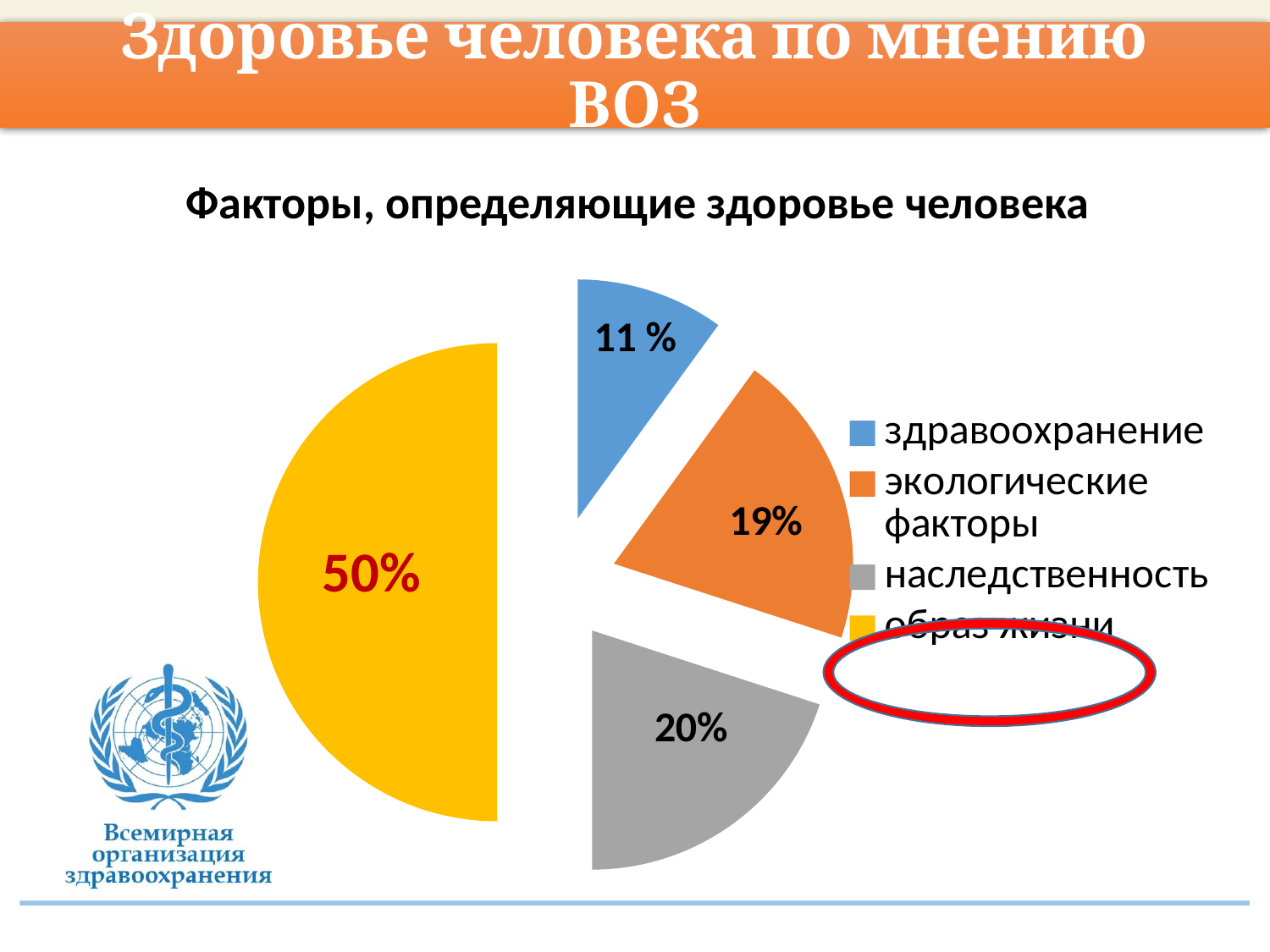
What share of the pie is labelled for образ жизни? 50% How many slices does the pie chart have? 4 Which factor has the largest slice of the pie? образ жизни How many entries does the legend list? 4 What value is shown for экологические факторы? 19% What is the title of the chart? Факторы, определяющие здоровье человека What value is shown for здравоохранение? 11 % What is the difference between the values for образ жизни and наследственность? 30% What kind of chart is shown on the slide? pie chart Which factor has the smallest slice of the pie? здравоохранение What value is shown for наследственность? 20% Which colour represents образ жизни in the pie chart? yellow